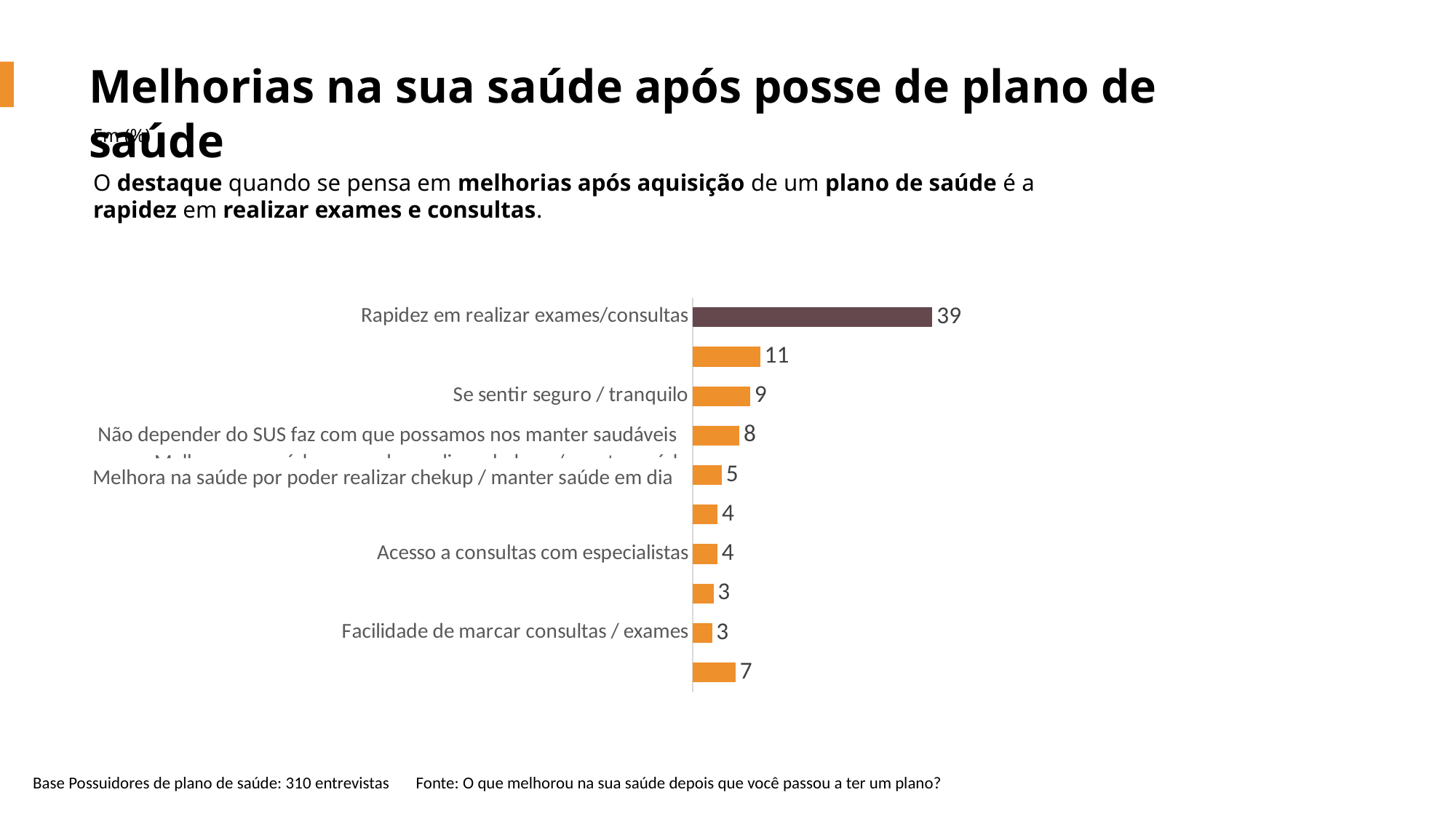
What is the value for Acesso a consultas com especialistas? 4 Which bar is shown in a different colour from the orange bars? Rapidez em realizar exames/consultas What is the value for Facilidade de marcar consultas / exames? 3 Which is larger: the value for Não depender do SUS faz com que possamos nos manter saudáveis or the value for Acesso a consultas com especialistas? Não depender do SUS faz com que possamos nos manter saudáveis Which category has the highest value? Rapidez em realizar exames/consultas What is the value for Melhora na saúde por poder realizar chekup / manter saúde em dia? 5 How many bars are plotted in the chart? 10 What is the value for Rapidez em realizar exames/consultas? 39 What is the difference between the values for Rapidez em realizar exames/consultas and Se sentir seguro / tranquilo? 30 What is the value for Não depender do SUS faz com que possamos nos manter saudáveis? 8 What kind of chart is shown on the slide? Bar chart What is the value for Se sentir seguro / tranquilo? 9